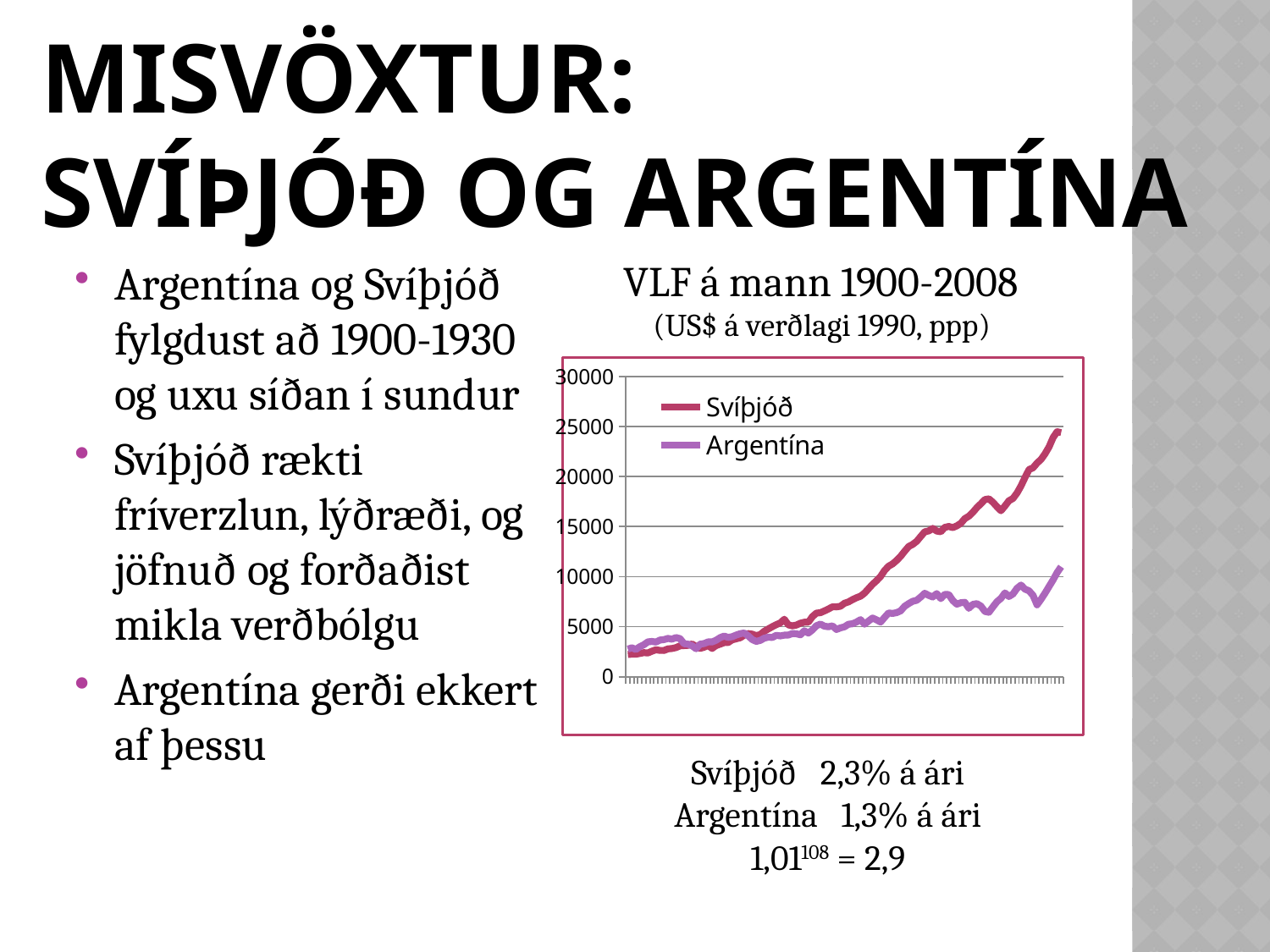
Is the final value for Svíþjóð greater or less than 20000? greater Is the value for Svíþjóð at the start of the chart greater or less than 5000? less What is the highest value shown on the y axis of the chart? 30000 What kind of chart is shown on the slide? line chart Which series ends at the higher value at the right end of the chart, Svíþjóð or Argentína? Svíþjóð Is the final value for Argentína greater or less than 15000? less Which series reaches the highest value on the chart? Svíþjóð Which two series are listed in the chart legend? Svíþjóð and Argentína How many series does the chart legend list? 2 What is the title of the chart? VLF á mann 1900-2008 (US$ á verðlagi 1990, ppp) Does the Svíþjóð line generally rise or fall along the x axis? rise